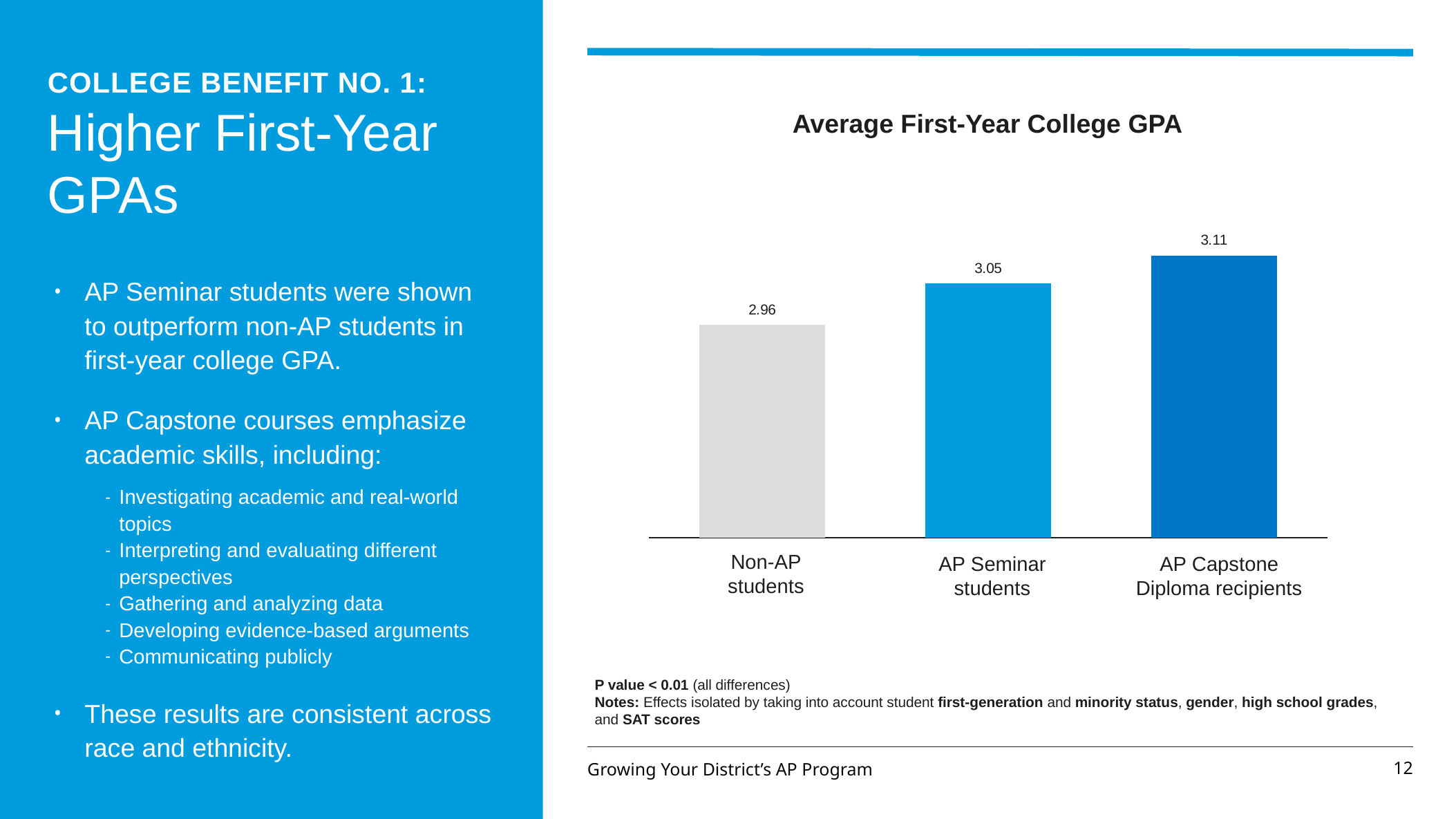
What is the average first-year college GPA for Non-AP students? 2.96 Which group has the lowest average first-year college GPA? Non-AP students What is the difference in average first-year college GPA between AP Seminar students and Non-AP students? 0.09 Which is larger: the average GPA for AP Seminar students or for Non-AP students? AP Seminar students What is the average first-year college GPA for AP Capstone Diploma recipients? 3.11 What is the title of the chart? Average First-Year College GPA Which group has the highest average first-year college GPA? AP Capstone Diploma recipients How many groups are shown in the chart? 3 Do the values rise or fall from left to right across the chart? Rise What is the average first-year college GPA for AP Seminar students? 3.05 What kind of chart is shown on the slide? Bar chart What is the difference in average first-year college GPA between AP Capstone Diploma recipients and Non-AP students? 0.15